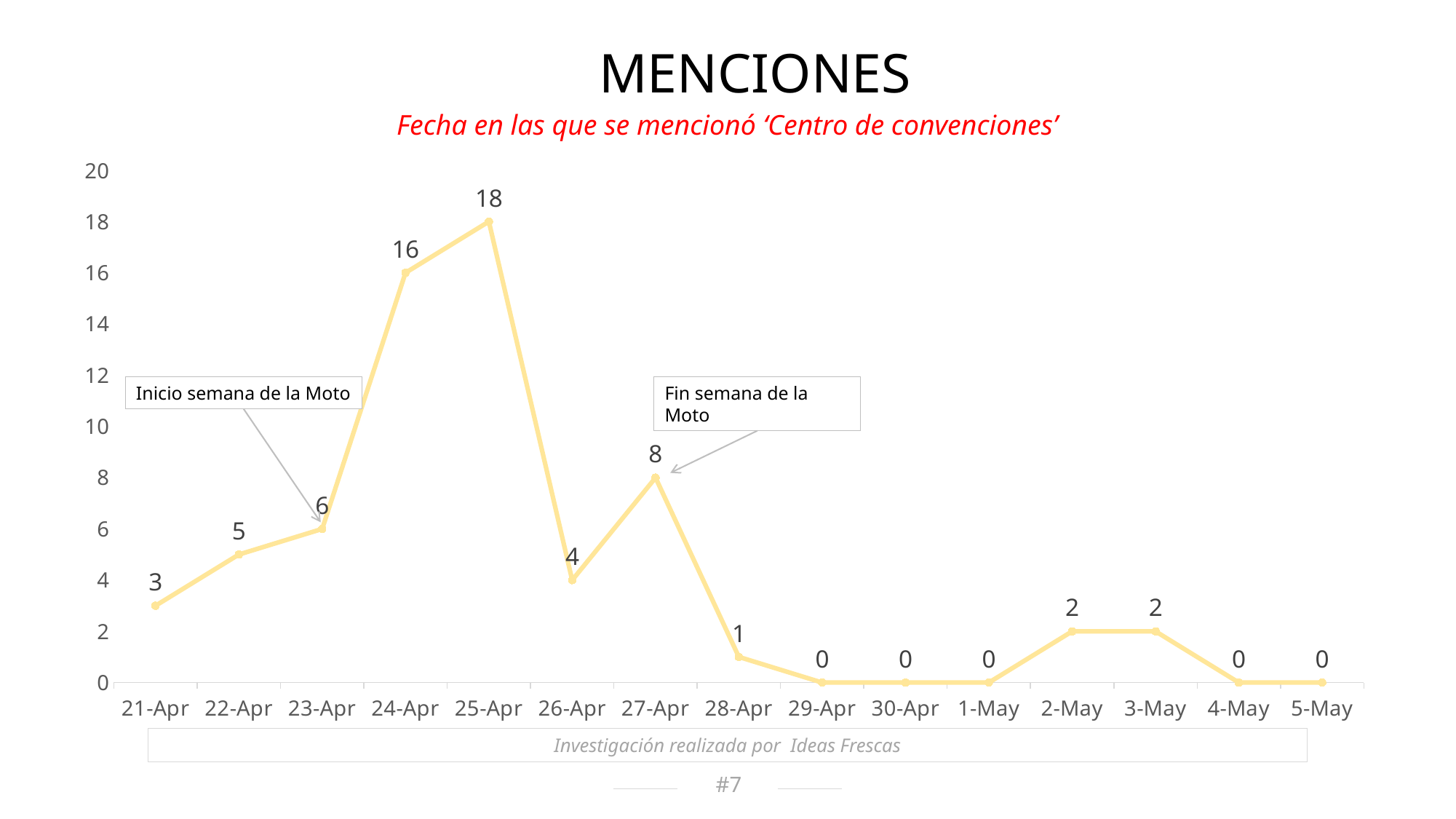
What is the value for 25-Apr? 18 What is the value for 27-Apr? 8 Which is larger, the value for 23-Apr or the value for 26-Apr? 23-Apr What kind of chart is shown? line chart What is the value for 21-Apr? 3 How many dates have a value of 0? 5 What is the difference between the values for 27-Apr and 26-Apr? 4 Which date has the highest value? 25-Apr How many dates are plotted on the x axis? 15 What is the difference between the values for 25-Apr and 24-Apr? 2 Do the values rise or fall from 21-Apr to 25-Apr? rise What is the title of the chart? MENCIONES